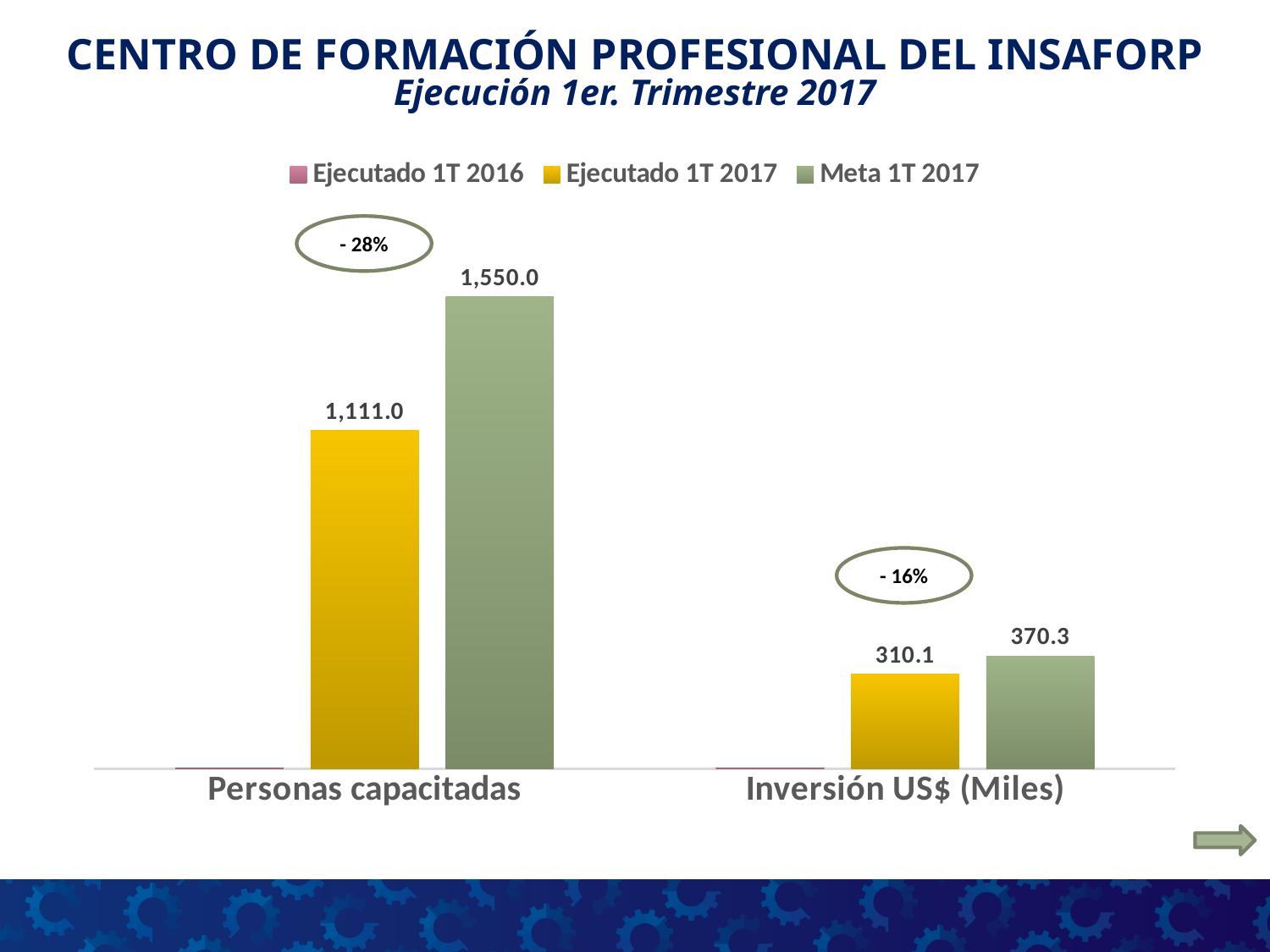
For Personas capacitadas, which is larger: Ejecutado 1T 2017 or Meta 1T 2017? Meta 1T 2017 What is the value of Meta 1T 2017 for Personas capacitadas? 1,550.0 What is the difference between Meta 1T 2017 and Ejecutado 1T 2017 for Personas capacitadas? 439.0 What percentage is shown in the circled annotation above the Inversión US$ (Miles) bars? - 16% How many series does the legend list? 3 What kind of chart is shown on the slide? Bar chart How many categories are shown on the x axis? 2 What is the value of Ejecutado 1T 2017 for Inversión US$ (Miles)? 310.1 What is the difference between Meta 1T 2017 and Ejecutado 1T 2017 for Inversión US$ (Miles)? 60.2 What is the value of Meta 1T 2017 for Inversión US$ (Miles)? 370.3 What is the value of Ejecutado 1T 2017 for Personas capacitadas? 1,111.0 Which category has the highest Meta 1T 2017 value? Personas capacitadas